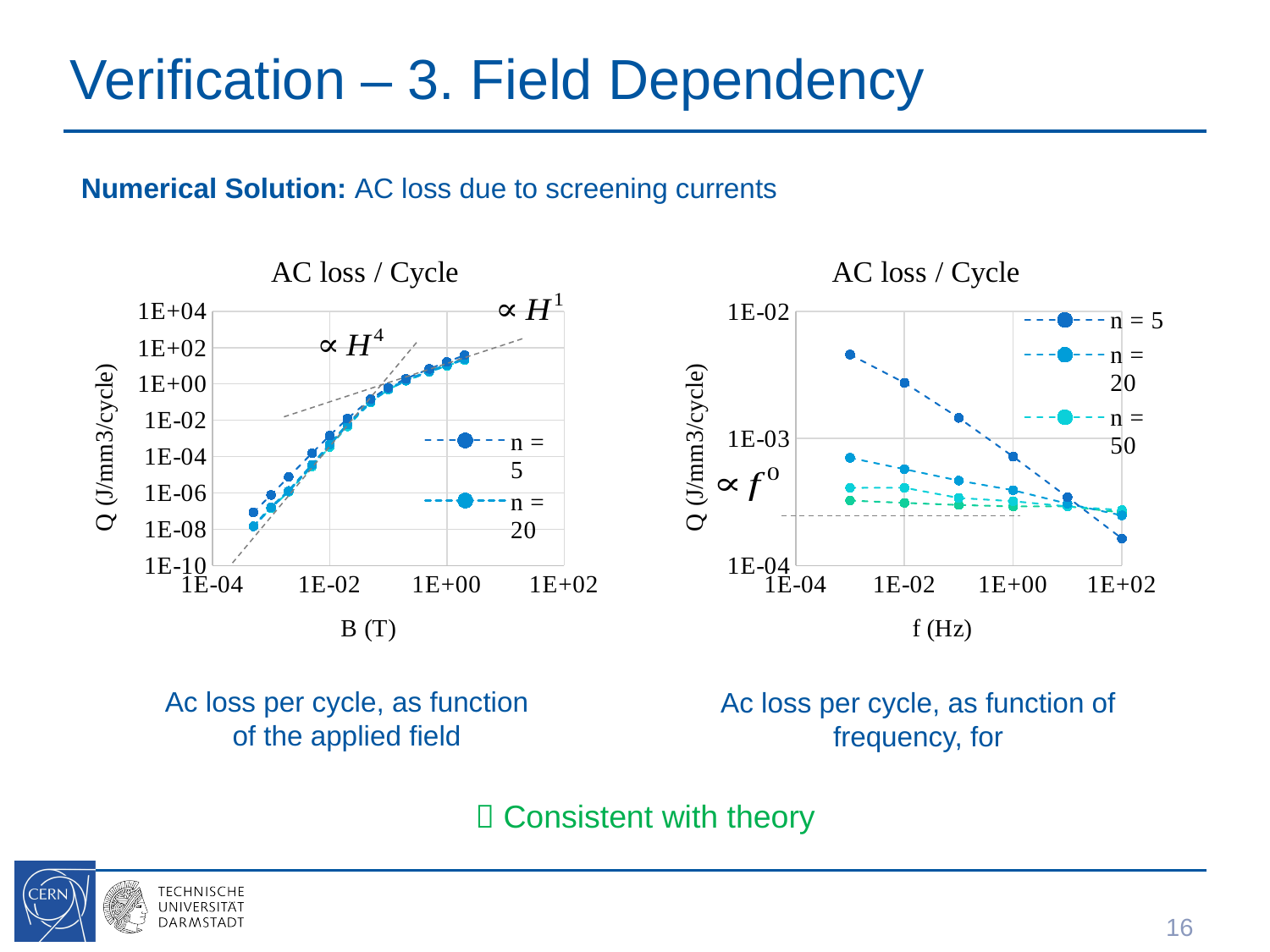
How many series does the legend of the right chart list? 3 How many series does the legend of the left chart list? 2 In the right chart, which series has the highest value at f = 1E-03? n = 5 In the right chart, is the value for n = 5 at f = 1E+02 greater or less than 1E-03? less What kind of chart is the left chart (AC loss / Cycle vs B)? line chart In the right chart, is the value for n = 5 at f = 1E-03 greater or less than 1E-03? greater In the left chart, is the value for n = 5 at B = 1E-02 greater or less than 1E-02? less What is the x-axis label of the right chart? f (Hz) In the left chart, do the values for n = 5 rise or fall as B increases? rise In the right chart, do the values for n = 5 rise or fall as f increases? fall